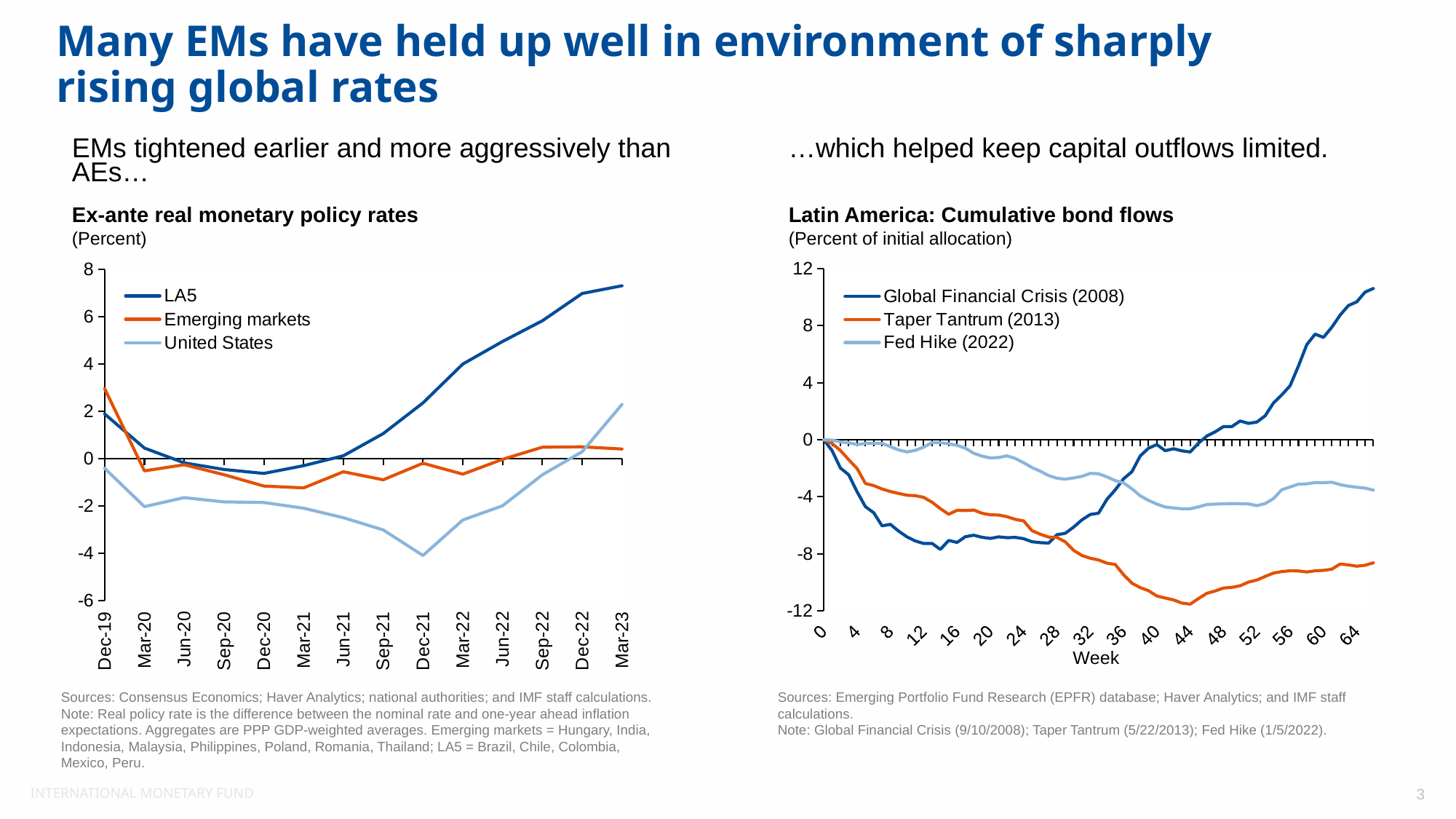
How many series does the legend of the 'Ex-ante real monetary policy rates' chart list? 3 In the 'Latin America: Cumulative bond flows' chart, is the Global Financial Crisis (2008) value at week 64 greater or less than 8? greater What kind of chart is the 'Latin America: Cumulative bond flows' chart? line chart In the 'Ex-ante real monetary policy rates' chart, does the LA5 line rise or fall between Jun-21 and Mar-23? rise In the 'Ex-ante real monetary policy rates' chart, which is larger at Dec-19: LA5 or Emerging markets? Emerging markets What kind of chart is the 'Ex-ante real monetary policy rates' chart? line chart In the 'Latin America: Cumulative bond flows' chart, which series has the lowest value at week 44? Taper Tantrum (2013) In the 'Ex-ante real monetary policy rates' chart, is the LA5 value at Mar-23 greater or less than 6? greater In the 'Ex-ante real monetary policy rates' chart, which series has the highest value at Mar-23? LA5 What is the unit shown under the title of the 'Latin America: Cumulative bond flows' chart? Percent of initial allocation How many series does the legend of the 'Latin America: Cumulative bond flows' chart list? 3 In the 'Ex-ante real monetary policy rates' chart, is the United States value at Dec-21 greater or less than -2? less